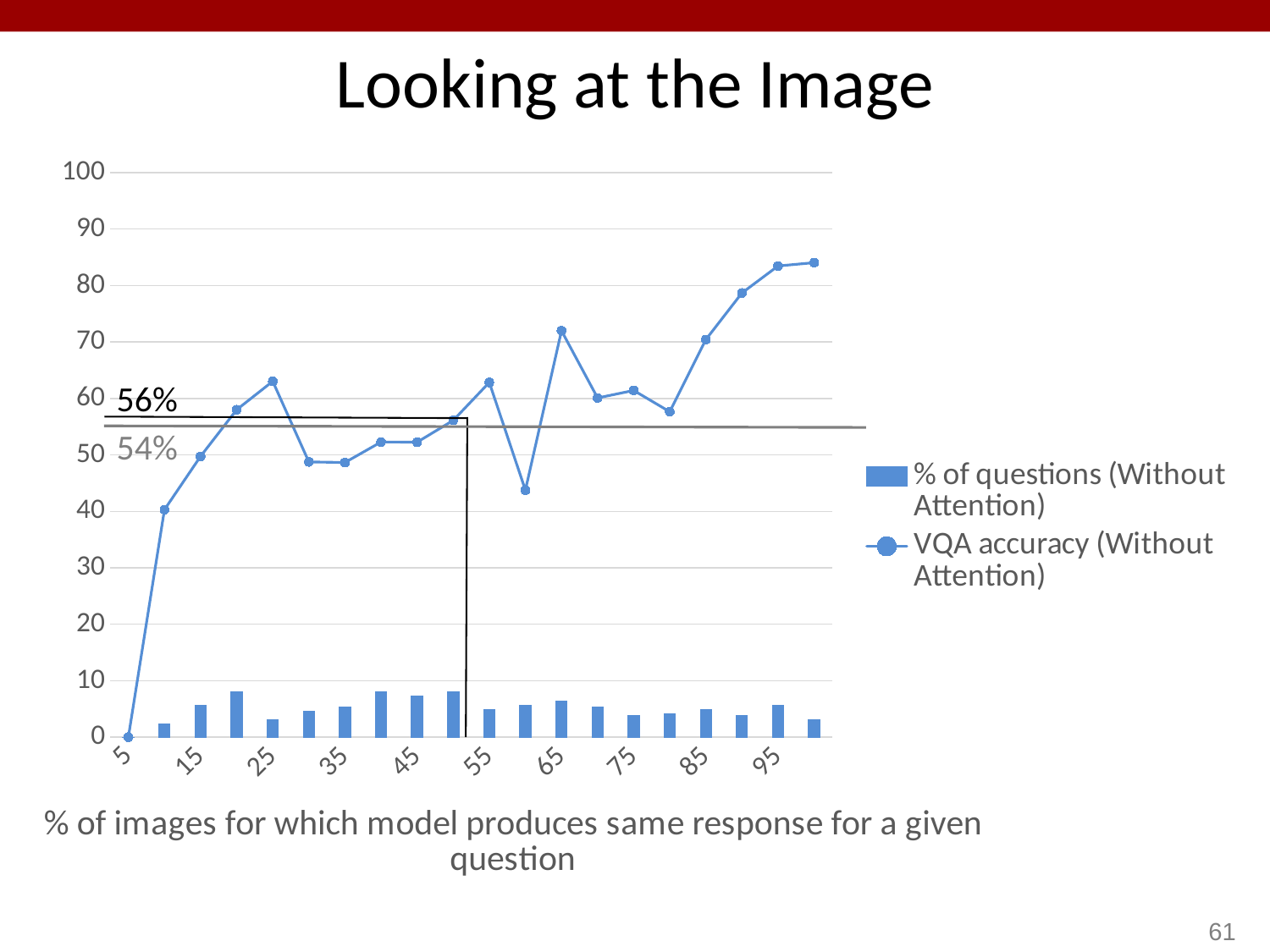
At which x value is the VQA accuracy (Without Attention) lowest? 5 Is the VQA accuracy (Without Attention) value at x = 90 greater or less than 70? greater What kind of chart is shown on the slide? A combined bar and line chart Is the VQA accuracy (Without Attention) value at x = 60 greater or less than 50? less How many series does the legend list? 2 Which series is drawn as a line with markers? VQA accuracy (Without Attention) Is the VQA accuracy (Without Attention) value at x = 95 greater or less than 80? greater Which is larger, the VQA accuracy (Without Attention) at x = 95 or at x = 60? x = 95 Overall, does the VQA accuracy (Without Attention) line rise or fall as x increases from 5 to 95? rise What two percentage values are annotated on the chart near the horizontal lines? 56% and 54%